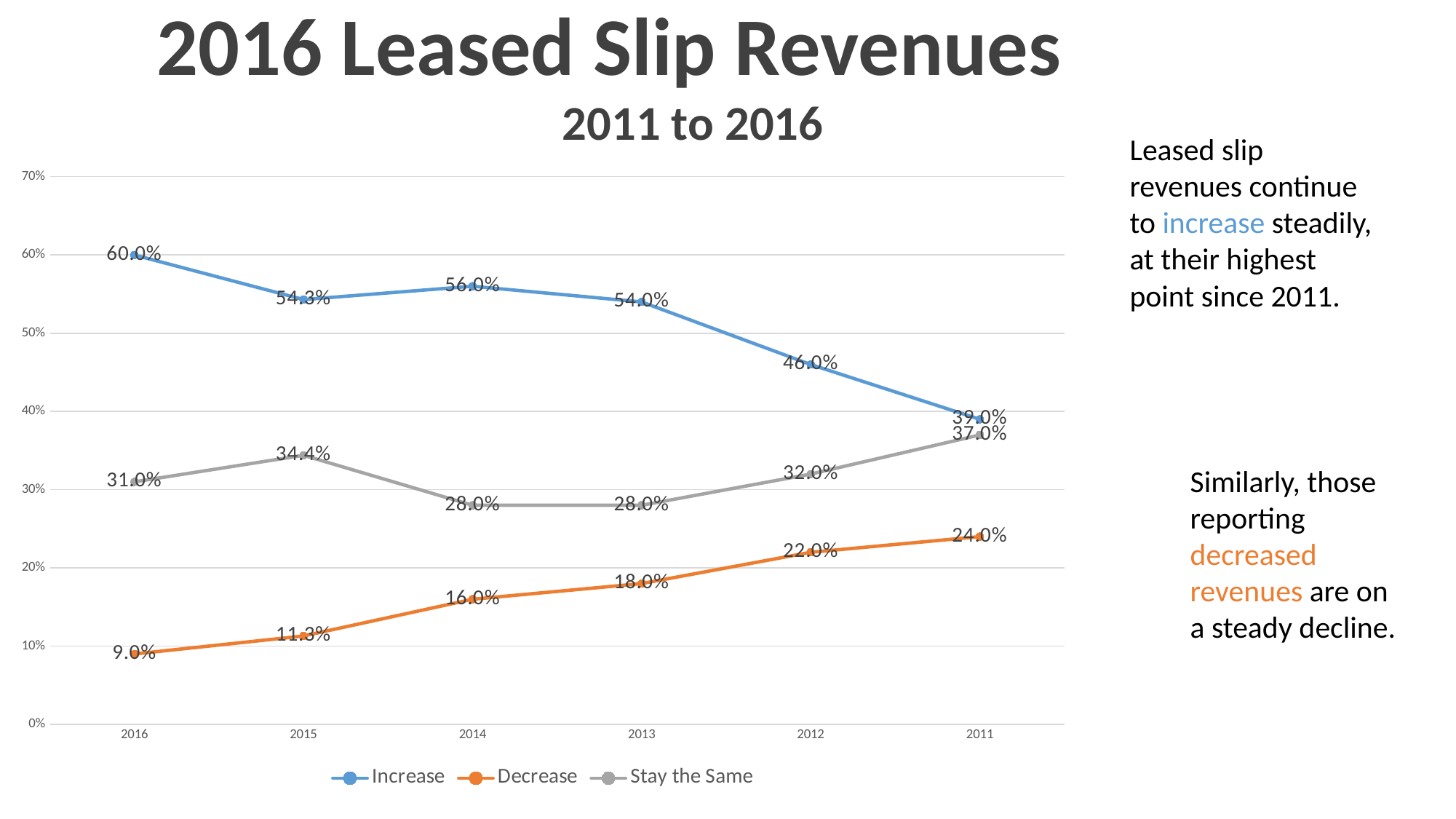
How many series does the legend list? 3 What is the subtitle shown below the chart title? 2011 to 2016 In which year is the Increase series at its highest? 2016 How many years are plotted on the x axis? 6 What is the value of the Increase series for 2016? 60.0% What is the value of the Decrease series for 2013? 18.0% What kind of chart is shown on the slide? Line chart What is the difference between the Increase value for 2016 and the Increase value for 2011? 21.0% Moving left to right along the x axis from 2016 to 2011, does the Decrease series rise or fall? Rise Which is larger for 2012: the Increase value or the Stay the Same value? Increase In which year is the Decrease series at its lowest? 2016 What is the value of the Stay the Same series for 2015? 34.4%